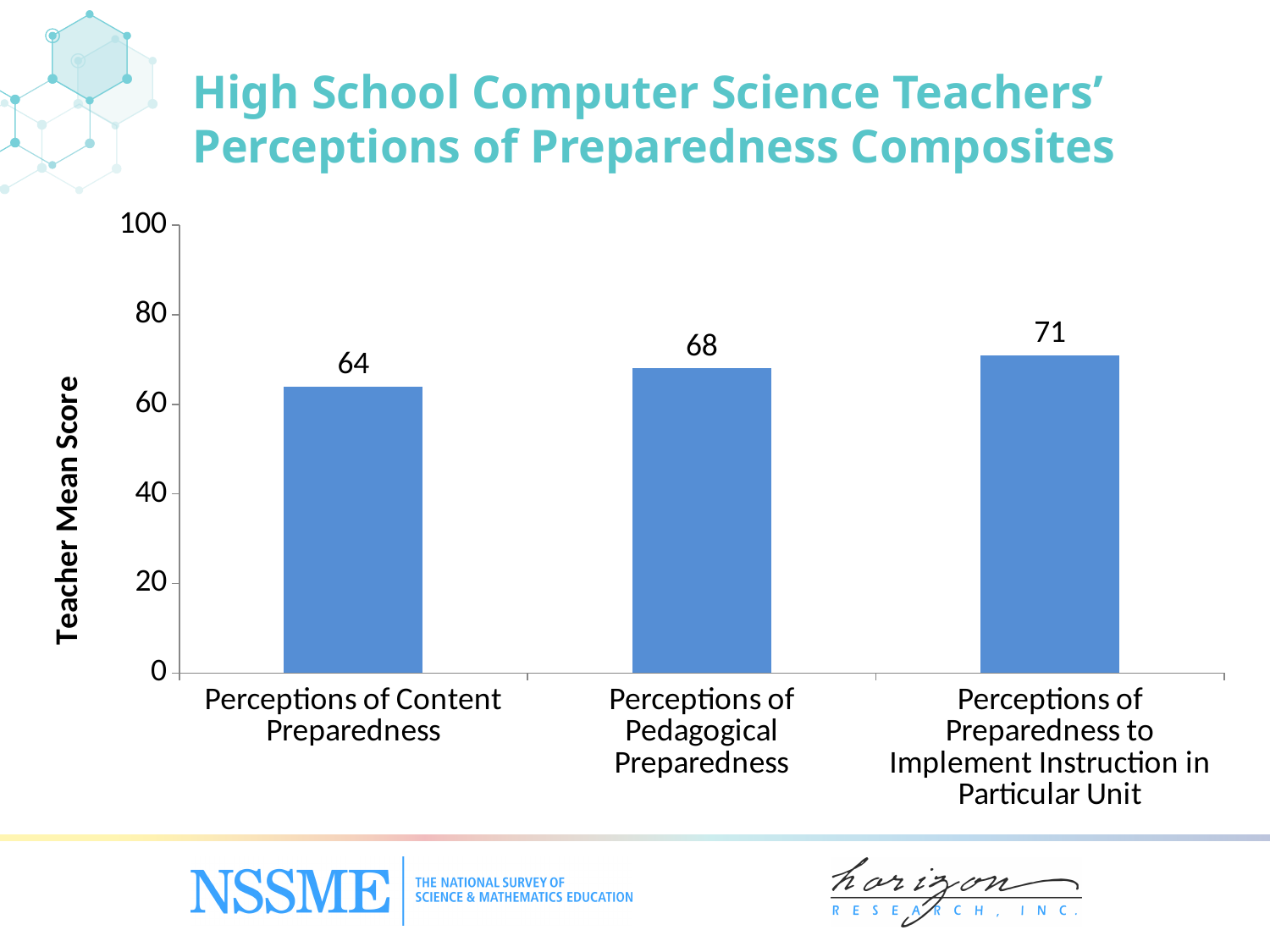
Which has a higher teacher mean score: Perceptions of Content Preparedness or Perceptions of Pedagogical Preparedness? Perceptions of Pedagogical Preparedness Which composite has the lowest teacher mean score? Perceptions of Content Preparedness How many composites are shown in the chart? 3 What kind of chart is shown on the slide? bar chart Is the teacher mean score for Perceptions of Content Preparedness greater or less than 80? less What is the difference between the teacher mean scores for Perceptions of Preparedness to Implement Instruction in Particular Unit and Perceptions of Content Preparedness? 7 What is the teacher mean score for Perceptions of Pedagogical Preparedness? 68 What is the teacher mean score for Perceptions of Preparedness to Implement Instruction in Particular Unit? 71 What is the teacher mean score for Perceptions of Content Preparedness? 64 Do the teacher mean scores rise or fall from left to right across the chart? rise Which composite has the highest teacher mean score? Perceptions of Preparedness to Implement Instruction in Particular Unit What is the difference between the teacher mean scores for Perceptions of Pedagogical Preparedness and Perceptions of Content Preparedness? 4